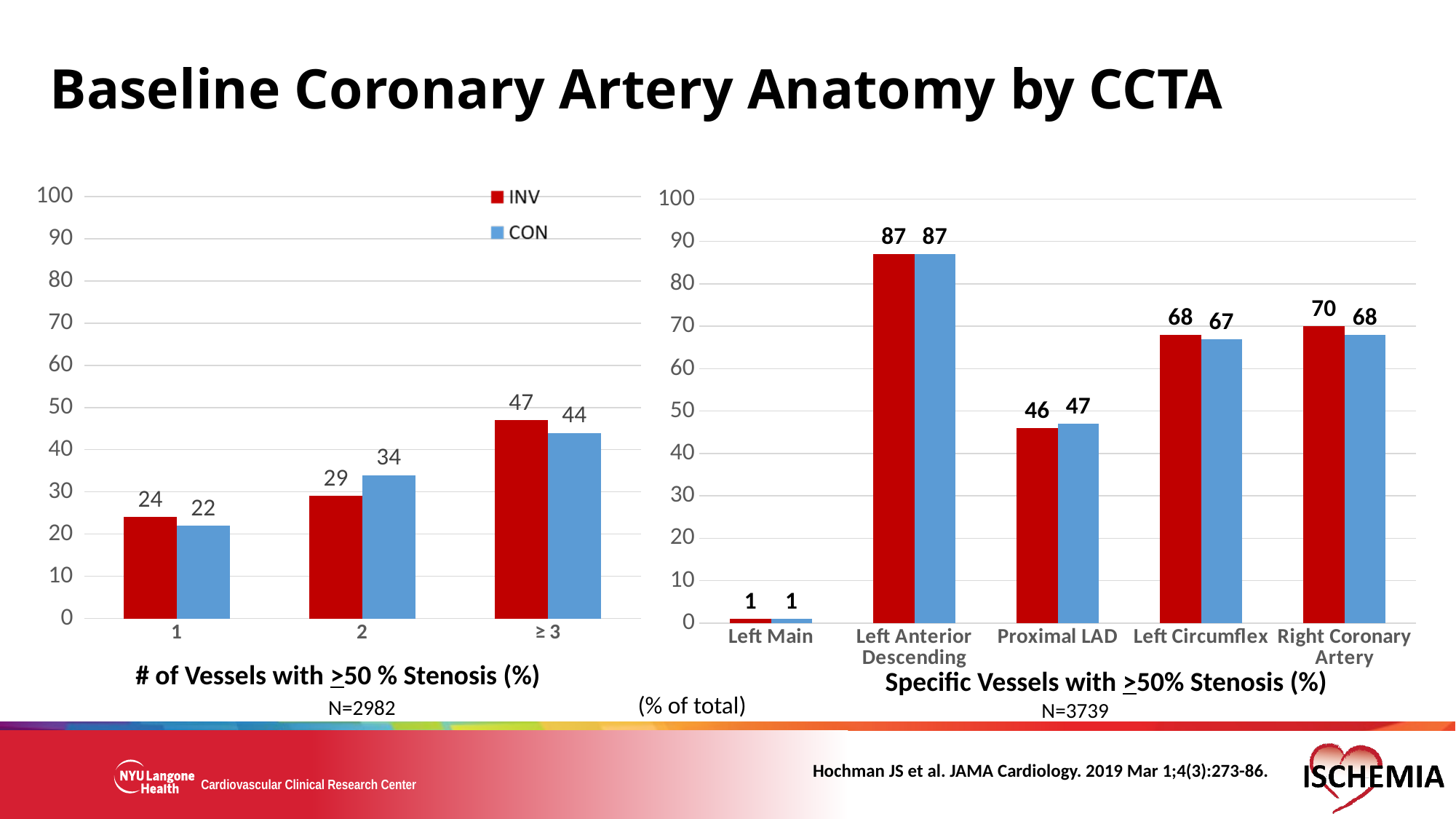
In the right chart (Specific Vessels with >50% Stenosis), what is the CON value for Proximal LAD? 47 How many series does the legend list? 2 In the right chart (Specific Vessels with >50% Stenosis), how many vessel categories are shown? 5 In the left chart (# of Vessels with >50% Stenosis), what is the INV value for 1 vessel? 24 In the right chart (Specific Vessels with >50% Stenosis), which vessel has the lowest values? Left Main In the left chart (# of Vessels with >50% Stenosis), which category has the highest INV value? ≥ 3 In the right chart (Specific Vessels with >50% Stenosis), what is the INV value for Right Coronary Artery? 70 What type of chart is the right chart (Specific Vessels with >50% Stenosis)? bar chart In the left chart (# of Vessels with >50% Stenosis), what is the difference between the INV and CON values for ≥ 3 vessels? 3 In the left chart (# of Vessels with >50% Stenosis), what is the CON value for 2 vessels? 34 In the right chart (Specific Vessels with >50% Stenosis), which vessel has the highest CON value? Left Anterior Descending In the left chart (# of Vessels with >50% Stenosis), do the INV values rise or fall as the number of vessels increases? rise